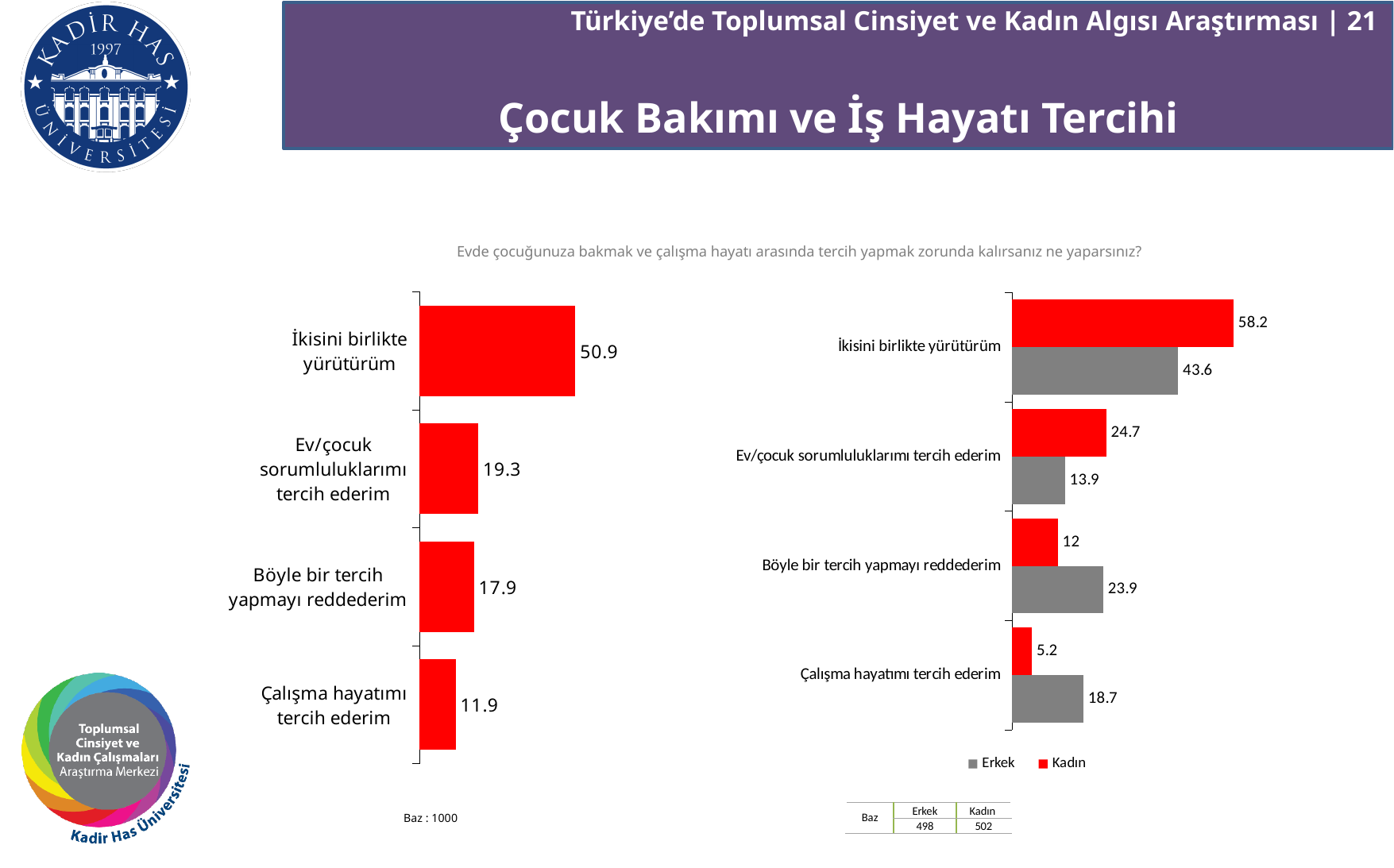
In the left chart, how many categories are shown? 4 In the left chart, which category has the lowest value? Çalışma hayatımı tercih ederim In the right chart, which is larger for "Böyle bir tercih yapmayı reddederim": Erkek or Kadın? Erkek In the right chart, what is the Kadın value for "İkisini birlikte yürütürüm"? 58.2 In the right chart, which series is shown in red? Kadın What kind of chart is the left chart? Bar chart In the right chart, which category has the highest Erkek value? İkisini birlikte yürütürüm In the left chart, what is the value for "İkisini birlikte yürütürüm"? 50.9 In the right chart, what is the difference between the Kadın and Erkek values for "Ev/çocuk sorumluluklarımı tercih ederim"? 10.8 In the right chart, what is the Erkek value for "Çalışma hayatımı tercih ederim"? 18.7 In the left chart, what is the difference between "Ev/çocuk sorumluluklarımı tercih ederim" and "Böyle bir tercih yapmayı reddederim"? 1.4 In the right chart, how many series does the legend list? 2